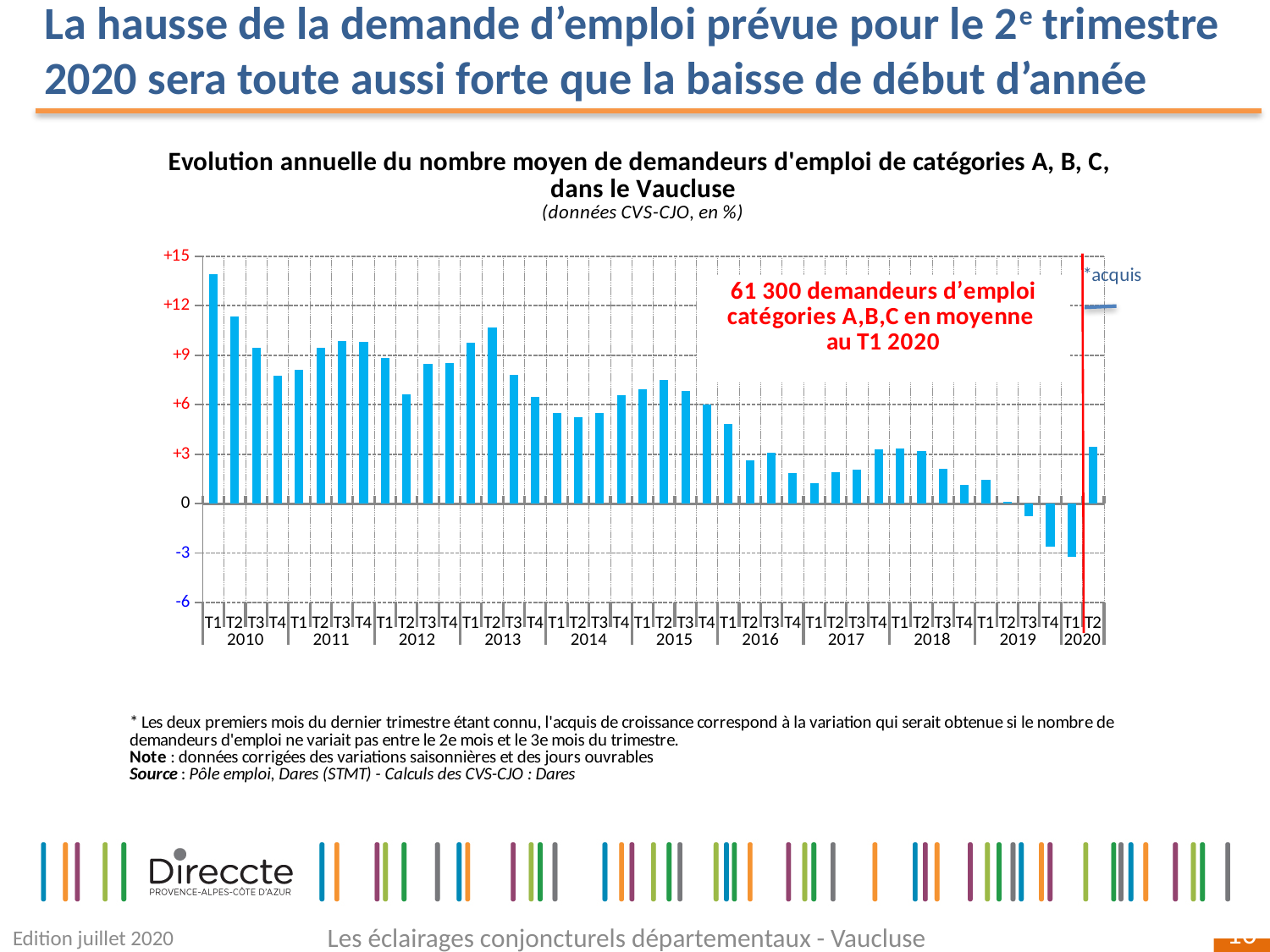
Is the value for T2 2013 greater or less than +9? greater What kind of chart is shown on the slide? bar chart How many quarterly bars are plotted in the chart? 42 Do the values generally rise or fall from 2010 to 2019? fall Is the value for T1 2010 greater or less than +12? greater Which is larger, the value for T2 2013 or the value for T3 2013? T2 2013 According to the annotation on the chart, how many demandeurs d'emploi catégories A,B,C were there on average in T1 2020? 61 300 Which quarter has the highest value in the chart? T1 2010 Which is larger, the value for T1 2020 or the value for T2 2020? T2 2020 Which quarter has the lowest value in the chart? T1 2020 Is the value for T3 2019 greater or less than 0? less